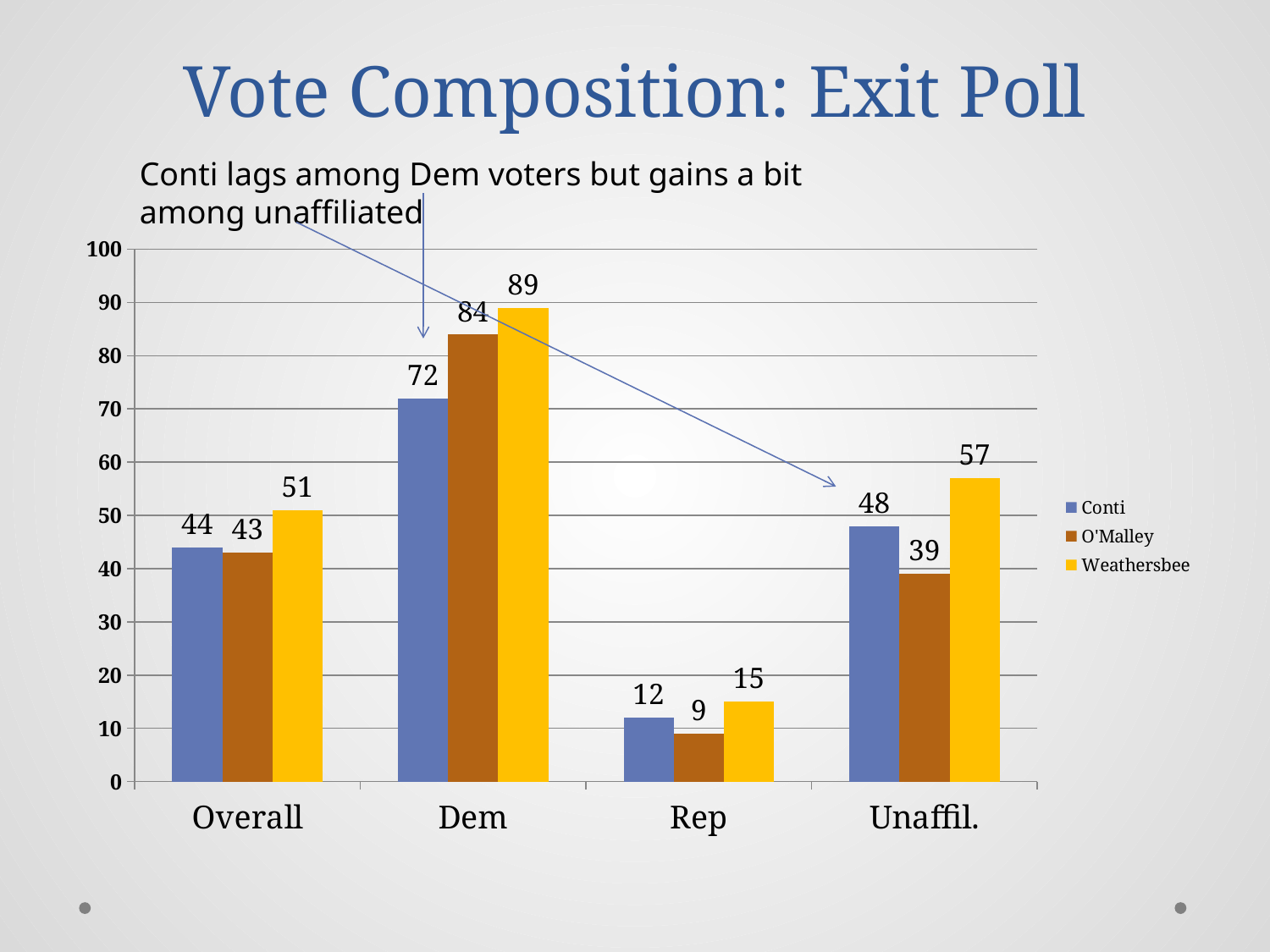
What is the value for Weathersbee in the Unaffil. category? 57 Which is larger in the Unaffil. category, Conti or O'Malley? Conti What is the value for Conti in the Dem category? 72 How many categories are shown on the x axis? 4 How many series does the legend list? 3 Which category has the lowest value for Conti? Rep Which series is shown in yellow in the legend? Weathersbee Is the value for O'Malley in the Dem category greater or less than 80? greater Which category has the highest value for Weathersbee? Dem What kind of chart is shown on the slide? bar chart What is the difference between Weathersbee and Conti in the Dem category? 17 What is the value for O'Malley in the Rep category? 9